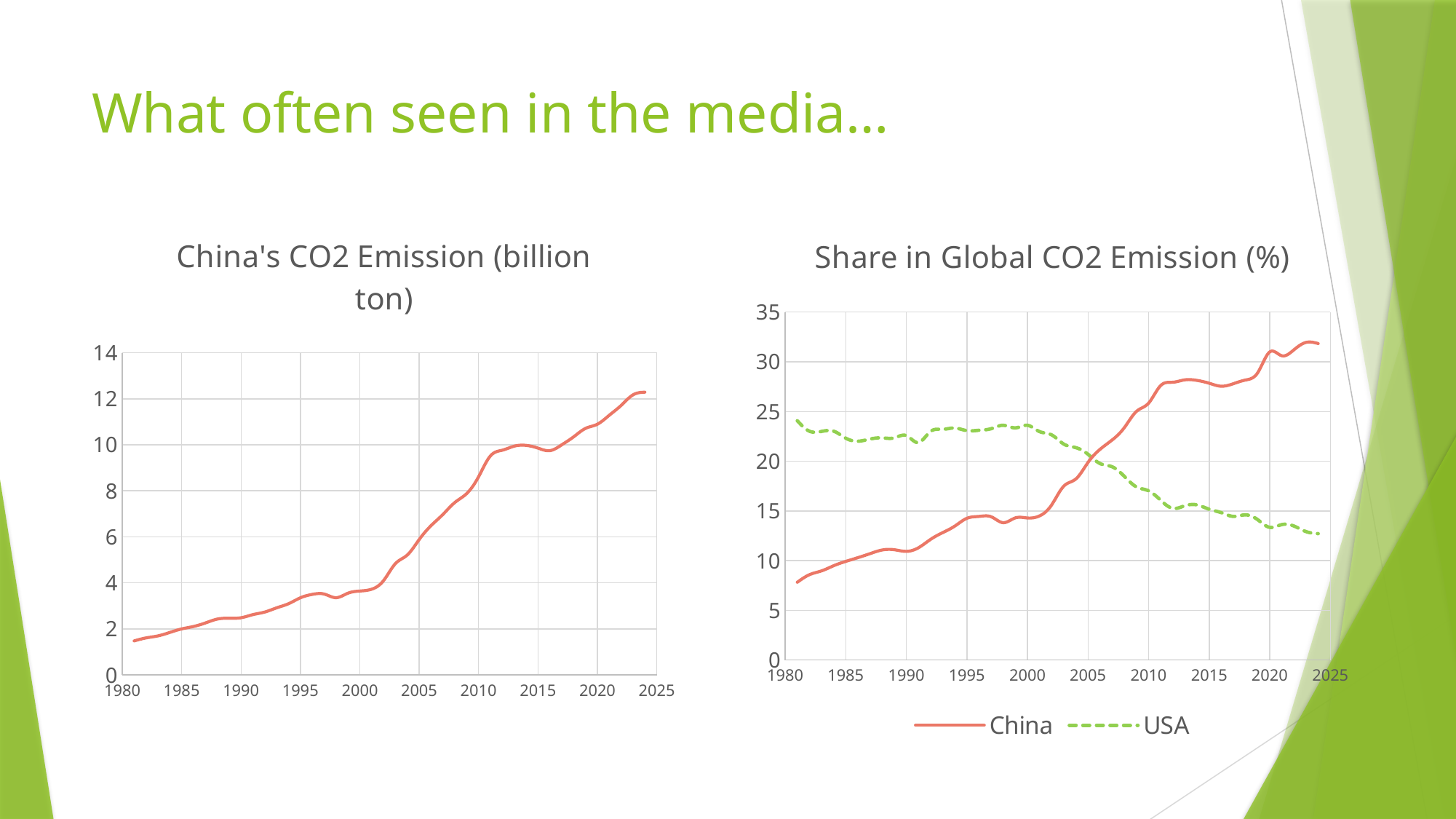
In the right chart, Share in Global CO2 Emission (%), does the China line generally rise or fall over time? rise What kind of chart is the right chart titled "Share in Global CO2 Emission (%)"? line chart In the right chart, Share in Global CO2 Emission (%), which series has the larger value in 1990, China or USA? USA In the right chart, Share in Global CO2 Emission (%), is the USA value for 1980 greater or less than 20? greater In the left chart, China's CO2 Emission (billion ton), is the value for 1990 greater or less than 4? less In the right chart, Share in Global CO2 Emission (%), is the China value for 1980 greater or less than 10? less What kind of chart is the left chart titled "China's CO2 Emission (billion ton)"? line chart In the right chart, Share in Global CO2 Emission (%), which series is drawn with a dashed line? USA How many series does the legend of the right chart, Share in Global CO2 Emission (%), list? 2 In the left chart, China's CO2 Emission (billion ton), do the values generally rise or fall from 1980 to 2025? rise In the right chart, Share in Global CO2 Emission (%), does the USA line generally rise or fall from 1980 to 2025? fall